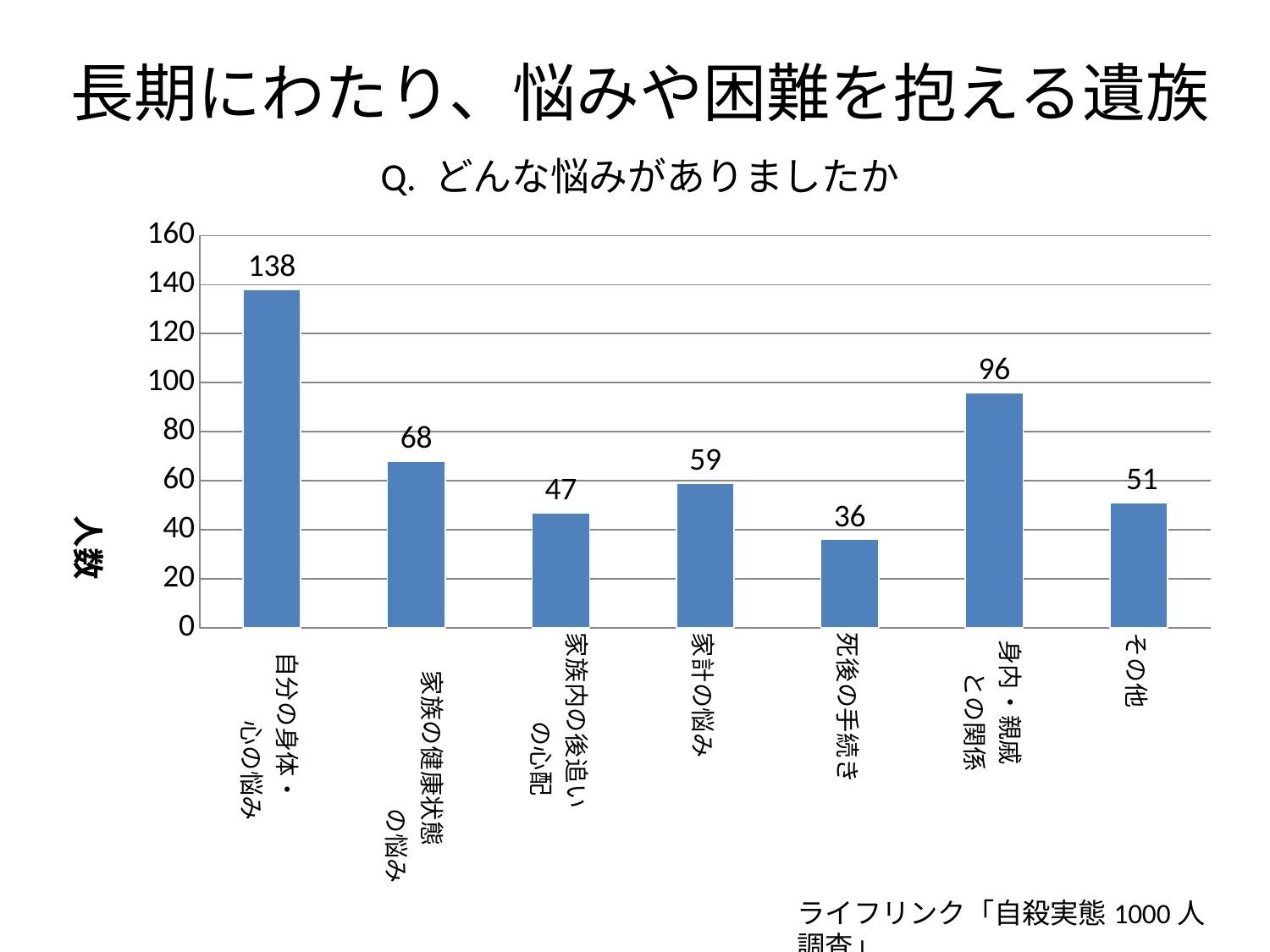
What is the value for その他? 51 What is the value for 身内・親戚との関係? 96 Is the value for 家族内の後追いの心配 greater or less than 60? less Which is larger, the value for 家族の健康状態の悩み or the value for 家計の悩み? 家族の健康状態の悩み What kind of chart is shown on the slide? bar chart How many categories are shown on the x axis? 7 What is the difference between the values for 自分の身体・心の悩み and 身内・親戚との関係? 42 What is the label of the y axis? 人数 Which category has the highest value? 自分の身体・心の悩み What is the value for 死後の手続き? 36 Which category has the lowest value? 死後の手続き What is the value for 自分の身体・心の悩み? 138